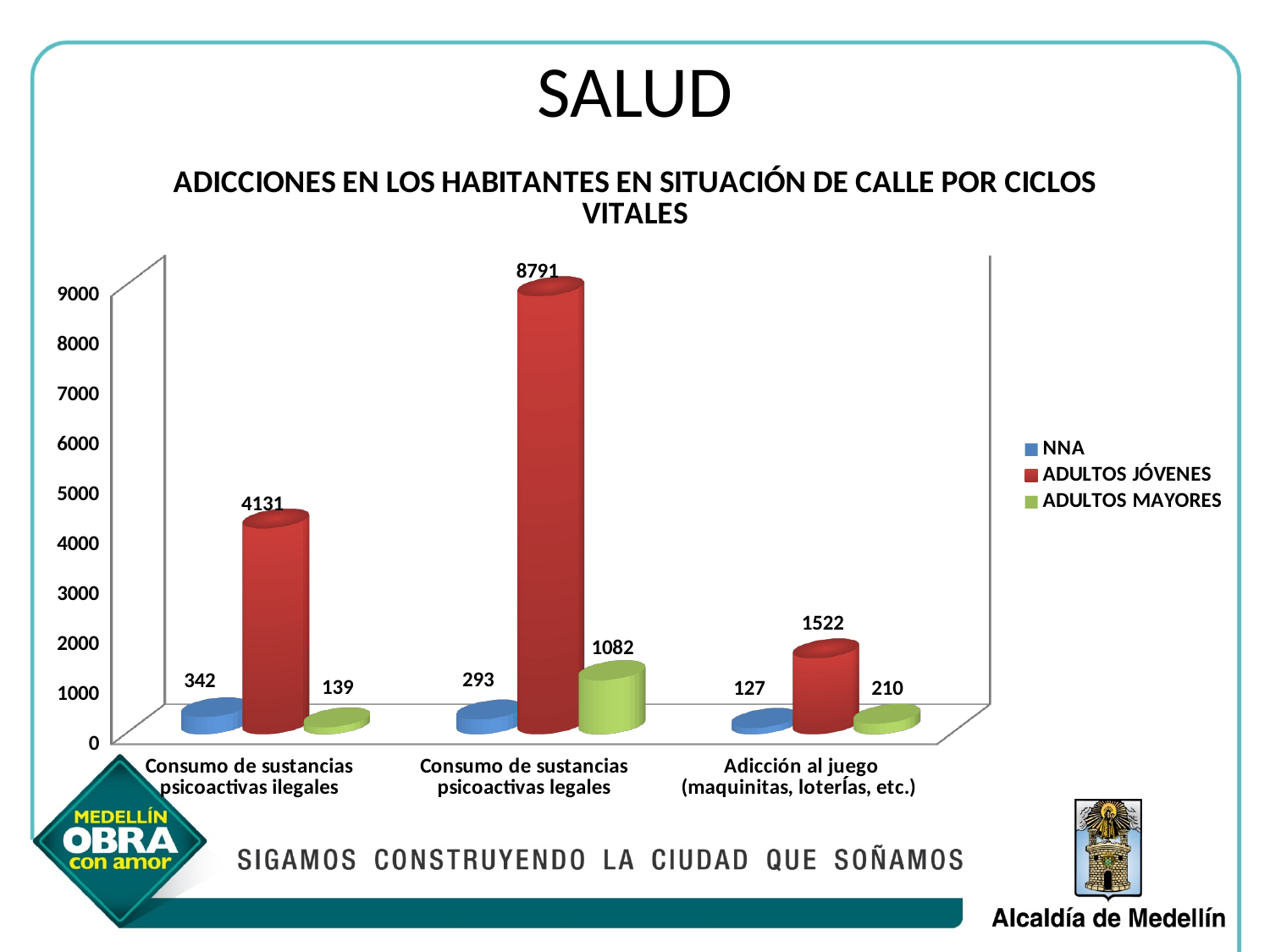
What is the difference between the ADULTOS JÓVENES values for 'Consumo de sustancias psicoactivas legales' and 'Consumo de sustancias psicoactivas ilegales'? 4660 How many categories are shown on the x axis? 3 What is the value for ADULTOS JÓVENES in the 'Consumo de sustancias psicoactivas legales' category? 8791 What is the title of the chart? ADICCIONES EN LOS HABITANTES EN SITUACIÓN DE CALLE POR CICLOS VITALES Which category has the highest value for ADULTOS JÓVENES? Consumo de sustancias psicoactivas legales What kind of chart is shown on the slide? Bar chart Which category has the lowest value for NNA? Adicción al juego (maquinitas, loterías, etc.) What is the value for ADULTOS MAYORES in the 'Adicción al juego (maquinitas, loterías, etc.)' category? 210 How many series does the legend list? 3 Is the ADULTOS JÓVENES value for 'Adicción al juego (maquinitas, loterías, etc.)' greater or less than 2000? less What is the value for NNA in the 'Consumo de sustancias psicoactivas ilegales' category? 342 Which is larger: the ADULTOS MAYORES value for 'Consumo de sustancias psicoactivas legales' or for 'Adicción al juego (maquinitas, loterías, etc.)'? Consumo de sustancias psicoactivas legales